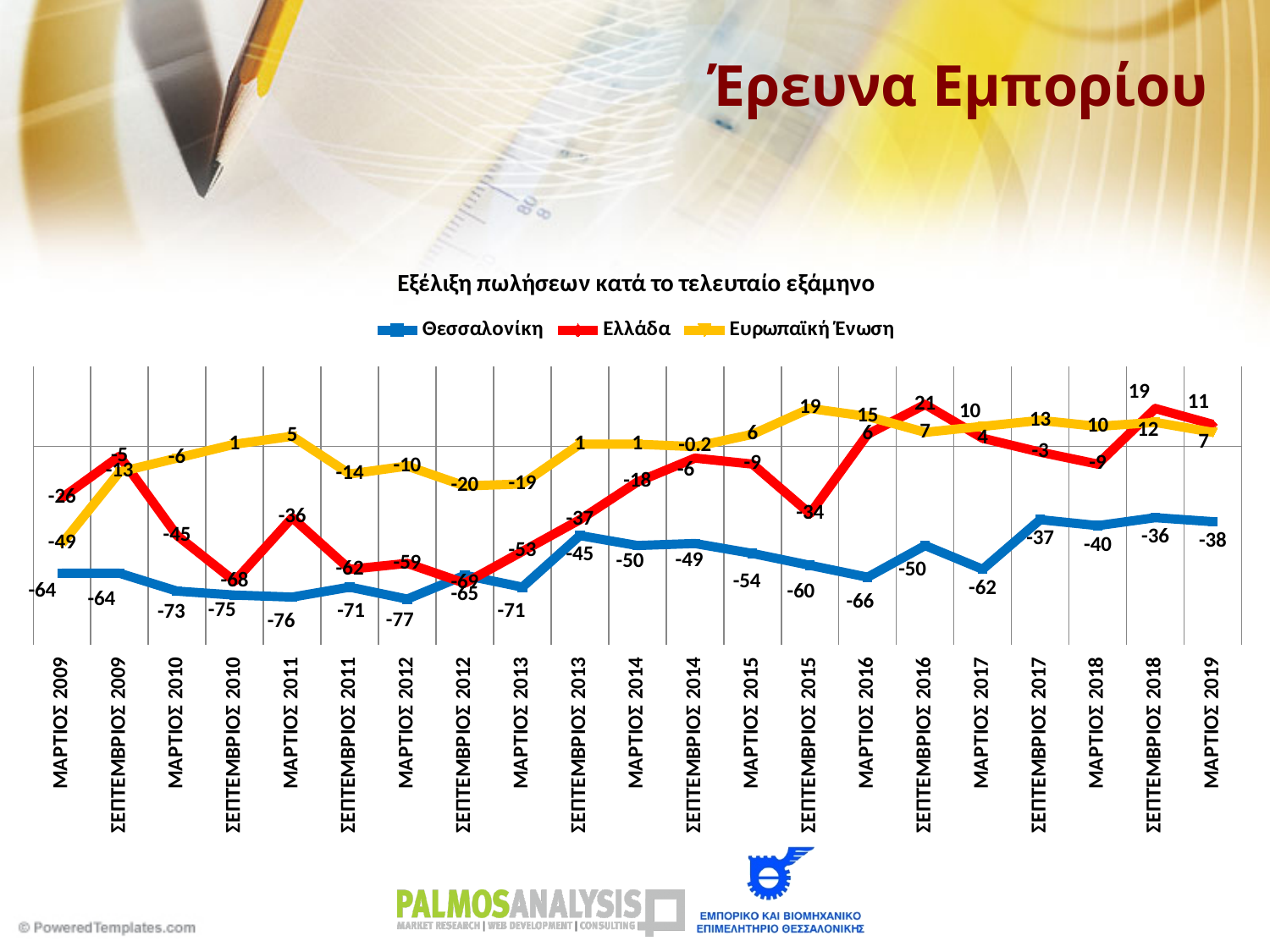
In which period does Ελλάδα reach its highest value? ΣΕΠΤΕΜΒΡΙΟΣ 2016 What kind of chart is shown on the slide? Line chart What is the value for Ευρωπαϊκή Ένωση in ΣΕΠΤΕΜΒΡΙΟΣ 2015? 19 What is the value for Θεσσαλονίκη in ΜΑΡΤΙΟΣ 2019? -38 What is the value for Ελλάδα in ΣΕΠΤΕΜΒΡΙΟΣ 2012? -69 What is the difference between the Ελλάδα and Θεσσαλονίκη values in ΜΑΡΤΙΟΣ 2019? 49 What is the value for Ελλάδα in ΣΕΠΤΕΜΒΡΙΟΣ 2016? 21 How many series does the legend list? 3 In which period does Θεσσαλονίκη reach its lowest value? ΜΑΡΤΙΟΣ 2012 How many time points are plotted along the x axis? 21 What colour is the line for Ελλάδα? Red In ΜΑΡΤΙΟΣ 2018, which is larger: the value for Ελλάδα or for Ευρωπαϊκή Ένωση? Ευρωπαϊκή Ένωση